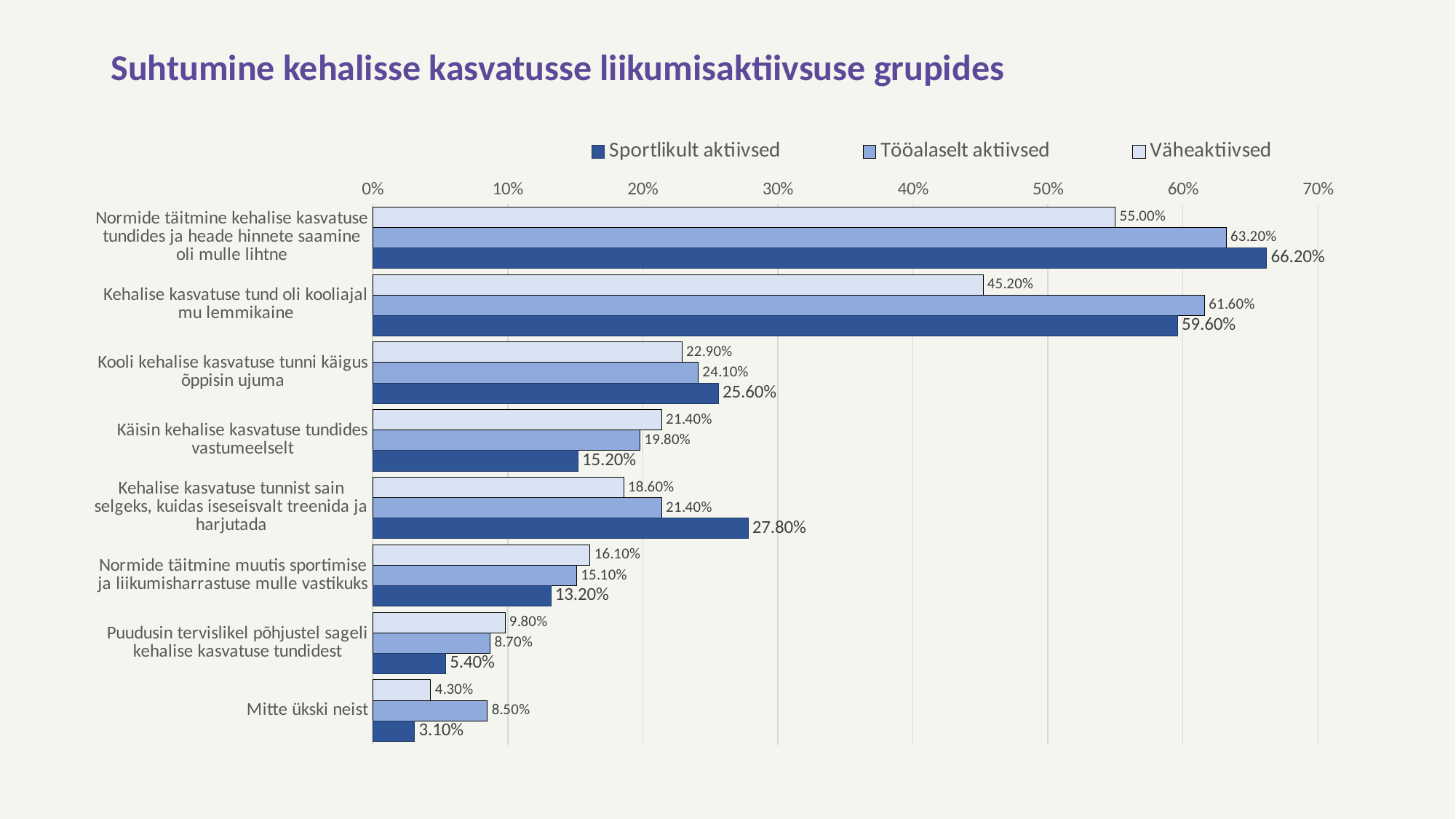
What is the value for Sportlikult aktiivsed in the category "Kehalise kasvatuse tund oli kooliajal mu lemmikaine"? 59.60% Which category has the lowest value for Tööalaselt aktiivsed? Mitte ükski neist What is the value for Väheaktiivsed in the category "Mitte ükski neist"? 4.30% In the category "Käisin kehalise kasvatuse tundides vastumeelselt", which series has the larger value: Sportlikult aktiivsed or Väheaktiivsed? Väheaktiivsed What is the difference between the Sportlikult aktiivsed and Väheaktiivsed values in the category "Kehalise kasvatuse tunnist sain selgeks, kuidas iseseisvalt treenida ja harjutada"? 9.20% Is the value for Väheaktiivsed in the category "Kehalise kasvatuse tund oli kooliajal mu lemmikaine" greater or less than 50%? less What is the title of the chart? Suhtumine kehalisse kasvatusse liikumisaktiivsuse grupides What is the value for Tööalaselt aktiivsed in the category "Kooli kehalise kasvatuse tunni käigus õppisin ujuma"? 24.10% How many series does the legend list? 3 Which category has the highest value for Sportlikult aktiivsed? Normide täitmine kehalise kasvatuse tundides ja heade hinnete saamine oli mulle lihtne How many categories are shown on the chart? 8 What kind of chart is shown on the slide? Bar chart